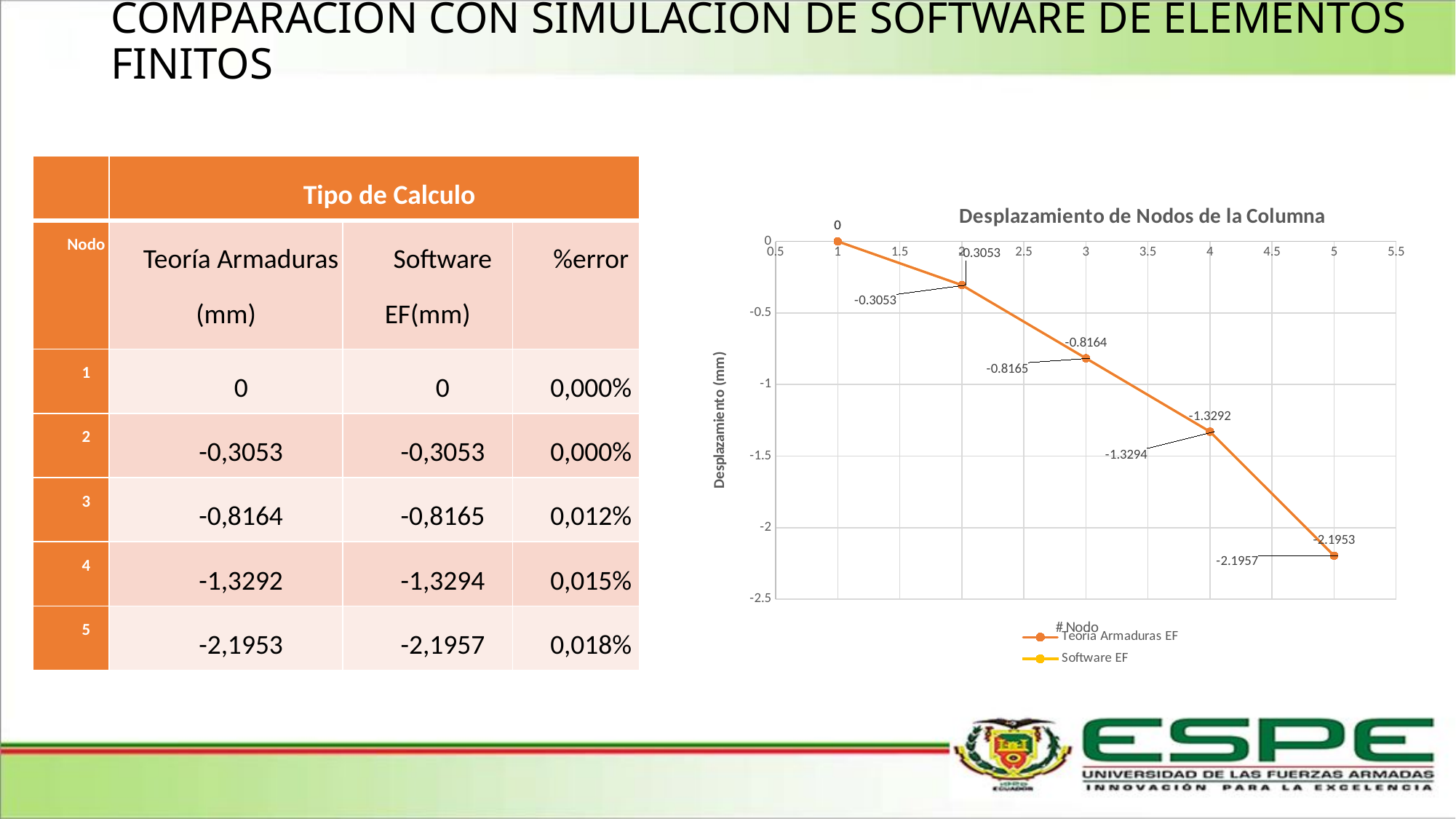
What is the displacement value labelled for the Teoría Armaduras EF series at node 3? -0.8164 How many series does the chart legend list? 2 How many nodes (data points) are plotted for the Teoría Armaduras EF series? 5 Is the Teoría Armaduras EF displacement at node 4 greater or less than -1? less What type of chart is shown on the slide? line chart What is the displacement value labelled for the Teoría Armaduras EF series at node 5? -2.1953 Do the displacement values rise or fall as the node number increases along the x axis? fall What is the displacement value labelled for the Software EF series at node 4? -1.3294 At which node is the Teoría Armaduras EF displacement lowest (most negative)? 5 What is the displacement value labelled for the Software EF series at node 5? -2.1957 What are the two series named in the chart legend? Teoría Armaduras EF and Software EF What is the title of the chart? Desplazamiento de Nodos de la Columna